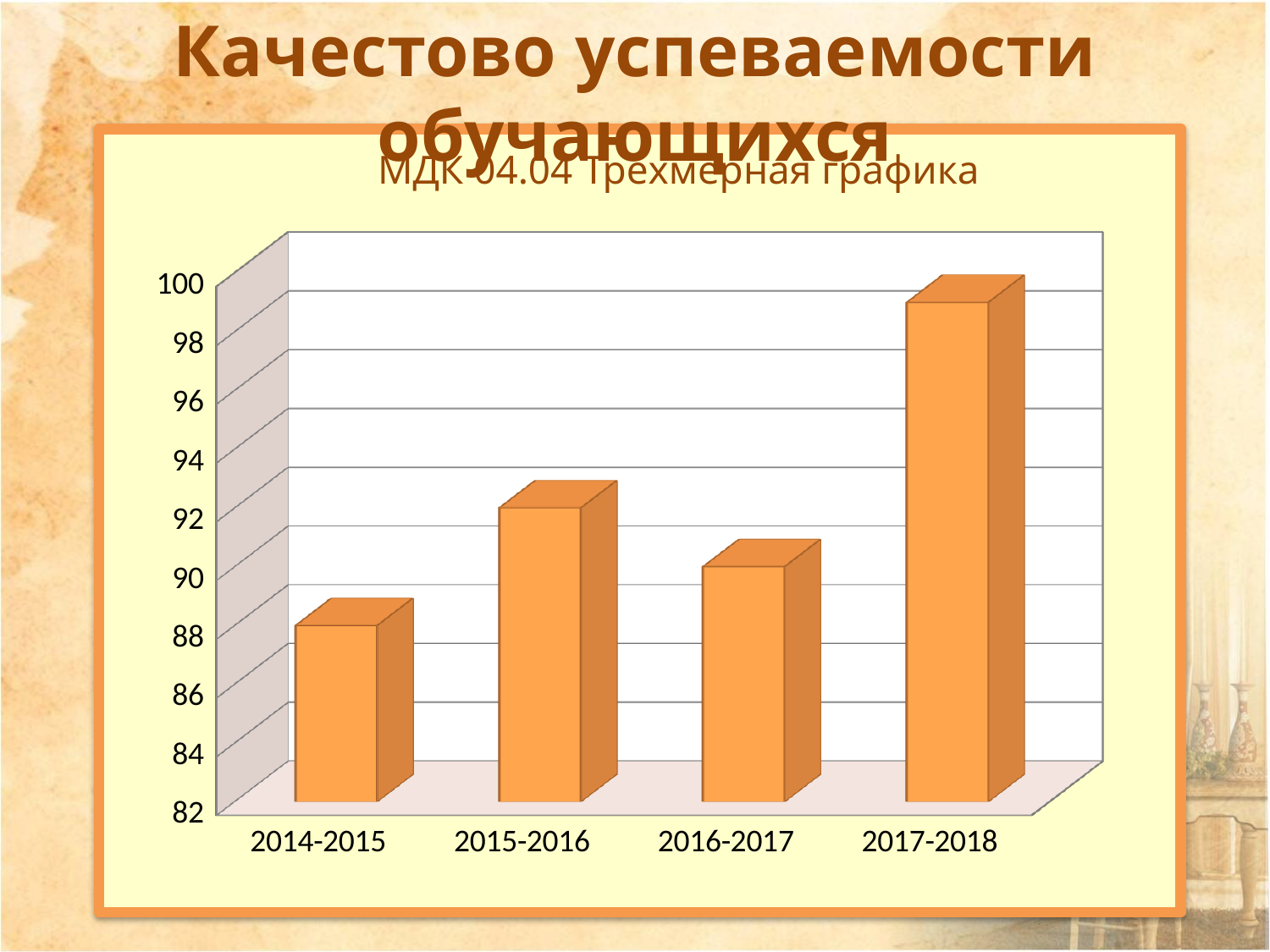
What is the lowest value shown on the vertical axis? 82 Does the value rise or fall from 2016-2017 to 2017-2018? rise Which academic year has the highest value? 2017-2018 Is the value for 2017-2018 greater or less than 96? greater Which is larger, the value for 2015-2016 or the value for 2016-2017? 2015-2016 What is the title shown above the chart? МДК 04.04 Трехмерная графика Which academic year has the lowest value? 2014-2015 Is the value for 2016-2017 greater or less than 92? less How many categories (academic years) are shown on the x axis? 4 Is the value for 2015-2016 greater or less than 90? greater What kind of chart is shown on the slide? bar chart